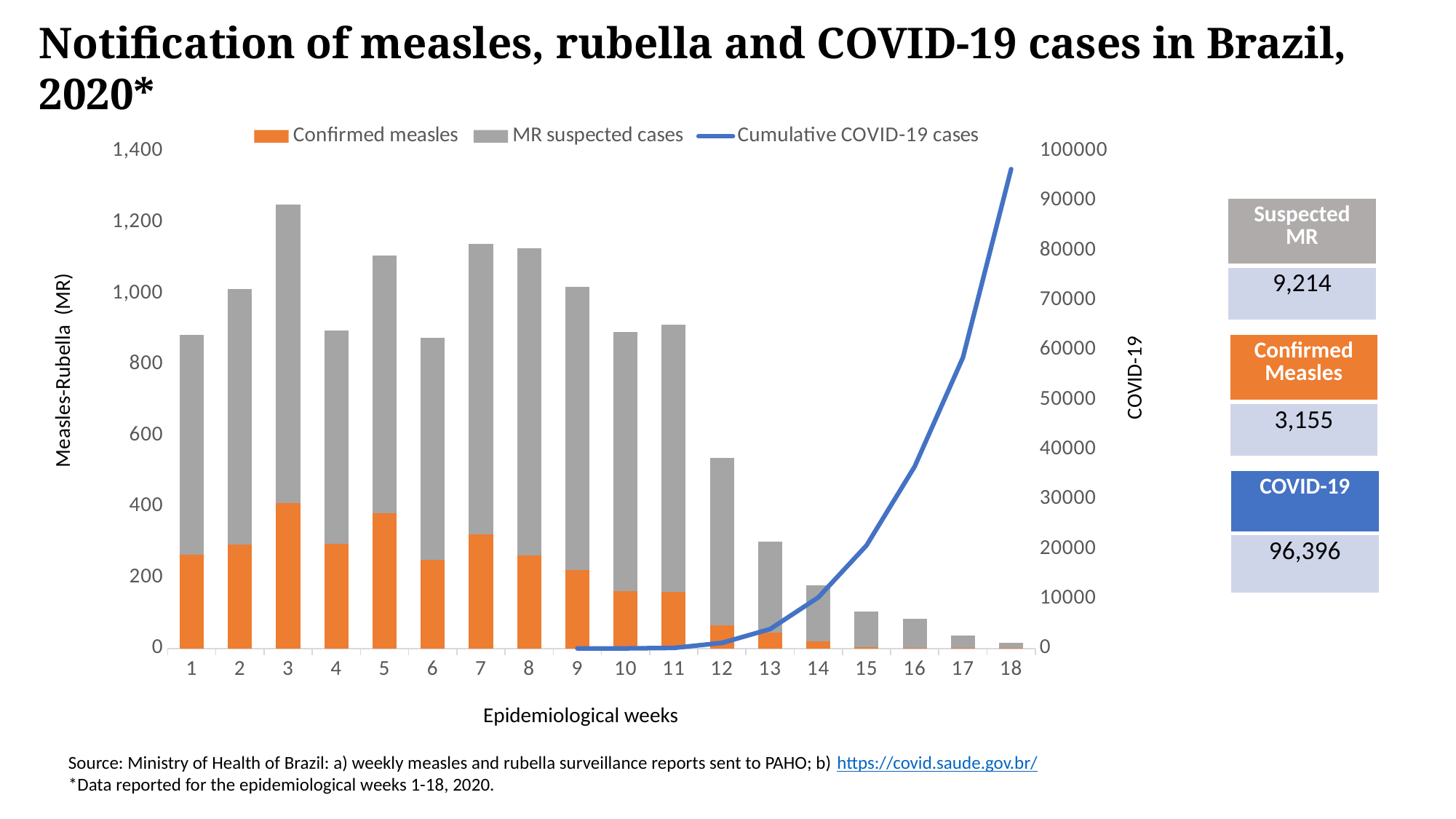
How many series does the legend list? 3 What kind of chart is shown on the slide? Combined stacked bar and line chart Is the total stacked bar value for week 1 greater or less than 800? greater Which has a taller stacked bar, week 3 or week 7? Week 3 According to the summary box on the right, what is the total number of COVID-19 cases? 96,396 Is the total stacked bar value for week 12 greater or less than 400? greater Is the Confirmed measles value for week 1 greater or less than 200? greater Which epidemiological week has the shortest stacked bar (lowest total MR cases)? Week 18 Which epidemiological week has the tallest stacked bar (highest total MR cases)? Week 3 How many epidemiological weeks are plotted on the x axis? 18 According to the summary box on the right, what is the total number of Suspected MR cases? 9,214 Does the Cumulative COVID-19 cases line rise or fall across the epidemiological weeks? Rises